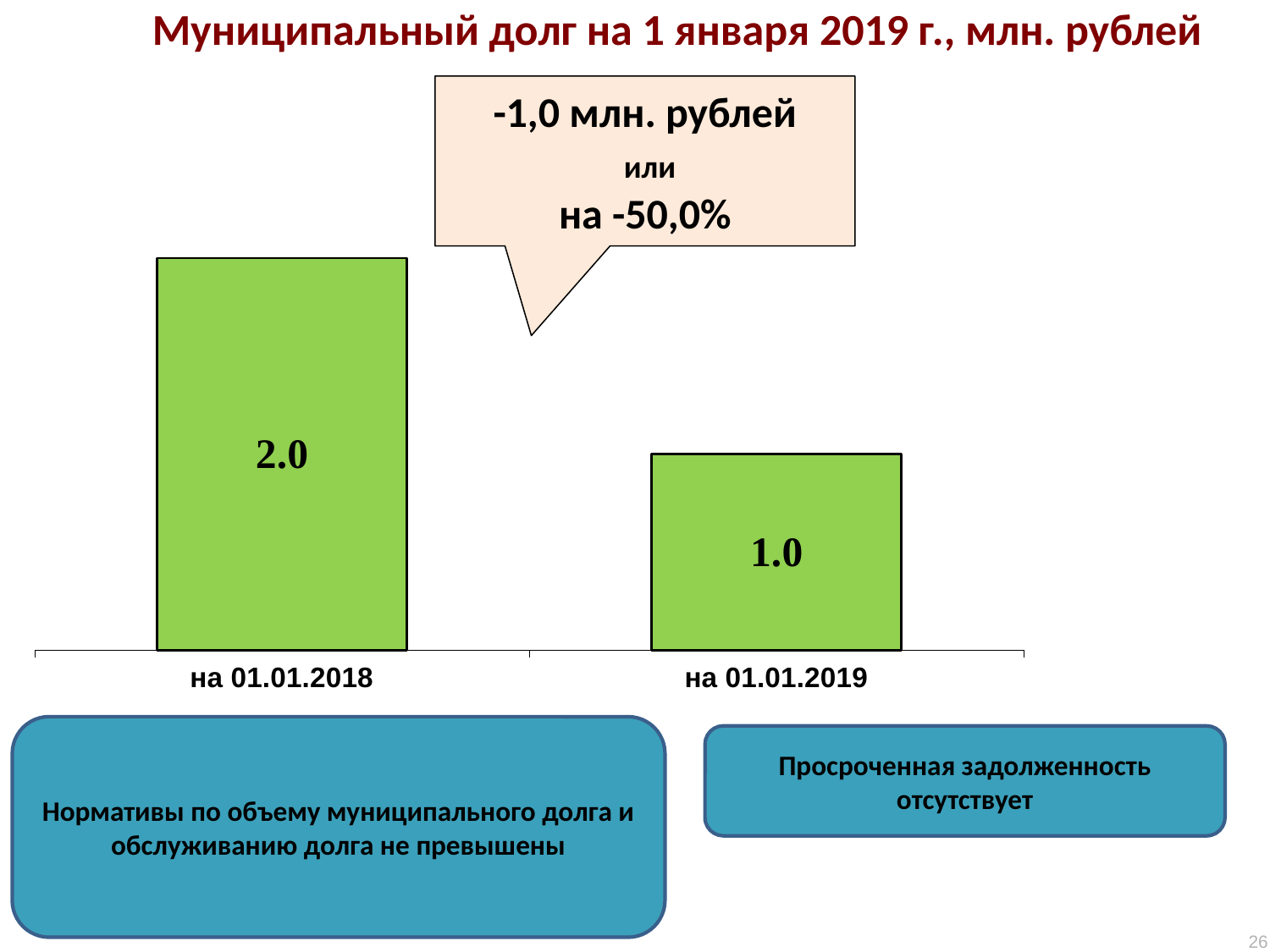
What percentage change does the callout on the chart state? -50,0% What is the value for на 01.01.2018? 2.0 What is the title of the chart? Муниципальный долг на 1 января 2019 г., млн. рублей Which category has the highest value? на 01.01.2018 Which is larger, the value for на 01.01.2018 or the value for на 01.01.2019? на 01.01.2018 What is the value for на 01.01.2019? 1.0 What kind of chart is shown on the slide? bar chart Which category has the lowest value? на 01.01.2019 What is the difference between the values for на 01.01.2018 and на 01.01.2019? 1.0 How many categories are shown on the chart? 2 Do the values rise or fall from на 01.01.2018 to на 01.01.2019? fall